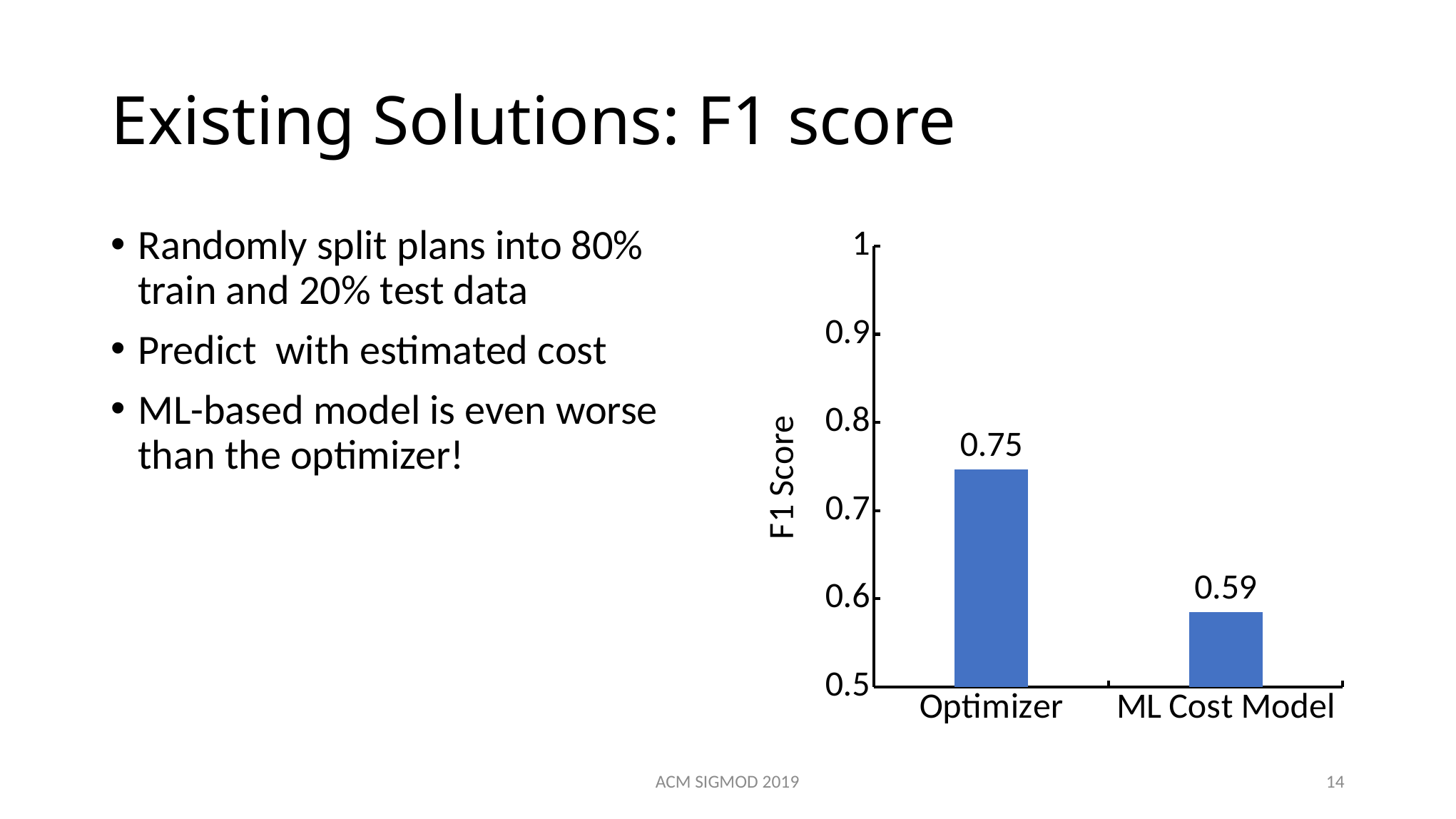
What is the F1 score for ML Cost Model? 0.59 What kind of chart is shown on the slide? bar chart Is the F1 score for Optimizer greater or less than 0.7? greater What is the difference between the F1 score of Optimizer and ML Cost Model? 0.16 Which category has the lowest F1 score? ML Cost Model Which category has the highest F1 score? Optimizer How many categories are shown in the chart? 2 What is the lowest value shown on the vertical axis of the chart? 0.5 Is the F1 score for ML Cost Model greater or less than 0.6? less Which has a larger F1 score, Optimizer or ML Cost Model? Optimizer What is the label of the vertical axis of the chart? F1 Score What is the F1 score for Optimizer? 0.75